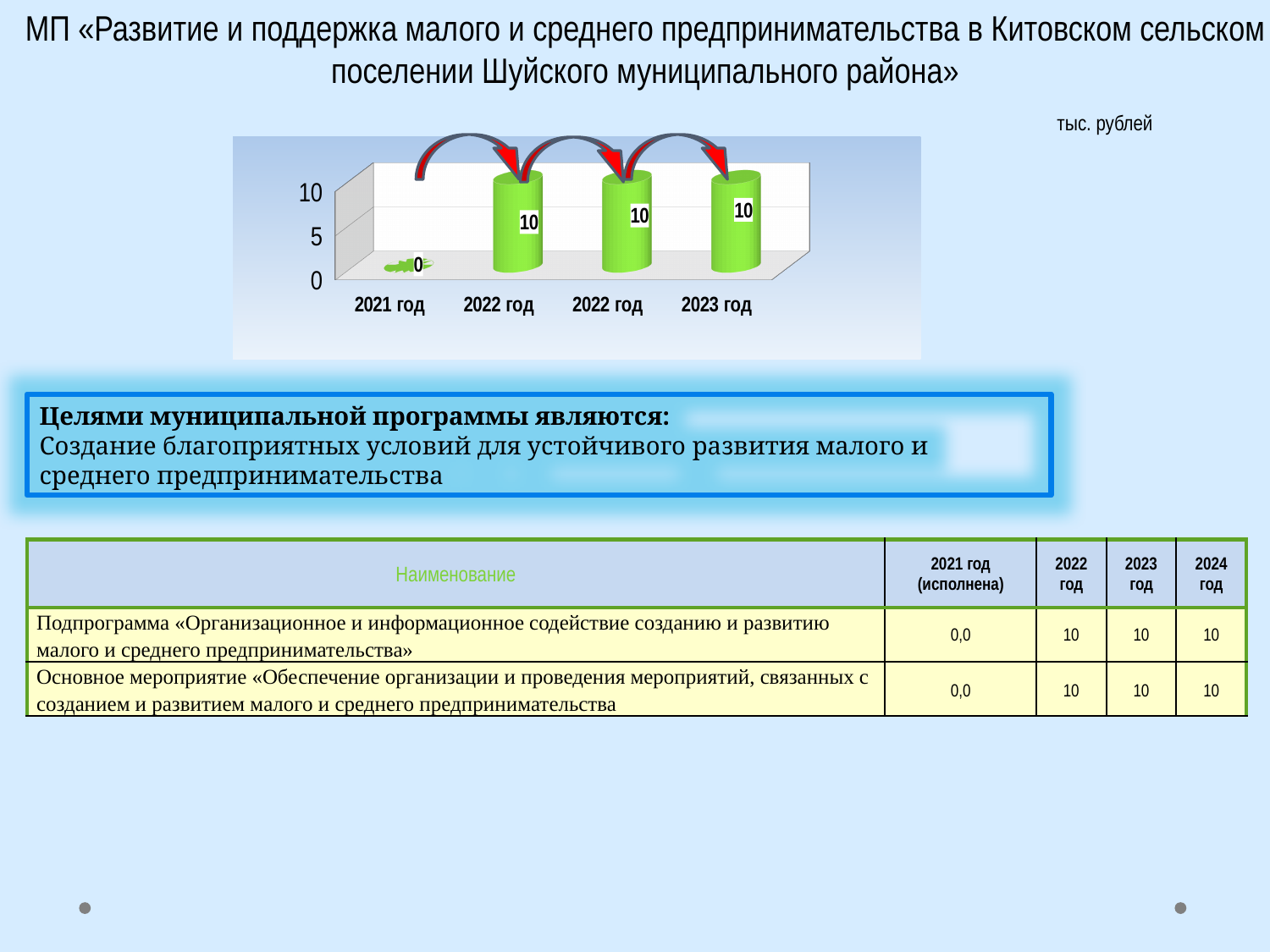
Is the value for 2021 год greater or less than 5? less What is the value for 2022 год in the chart? 10 What is the value for 2023 год in the chart? 10 Which is larger, the value for 2021 год or the value for 2023 год? 2023 год What is the difference between the values for 2023 год and 2021 год? 10 What kind of chart is shown on the slide? bar chart What is the highest tick value shown on the vertical axis of the chart? 10 What unit is indicated for the chart values? тыс. рублей What is the value for 2021 год in the chart? 0 Which category has the lowest value in the chart? 2021 год Do the values rise or fall from 2021 год to 2022 год? rise How many categories are shown on the x axis of the chart? 4